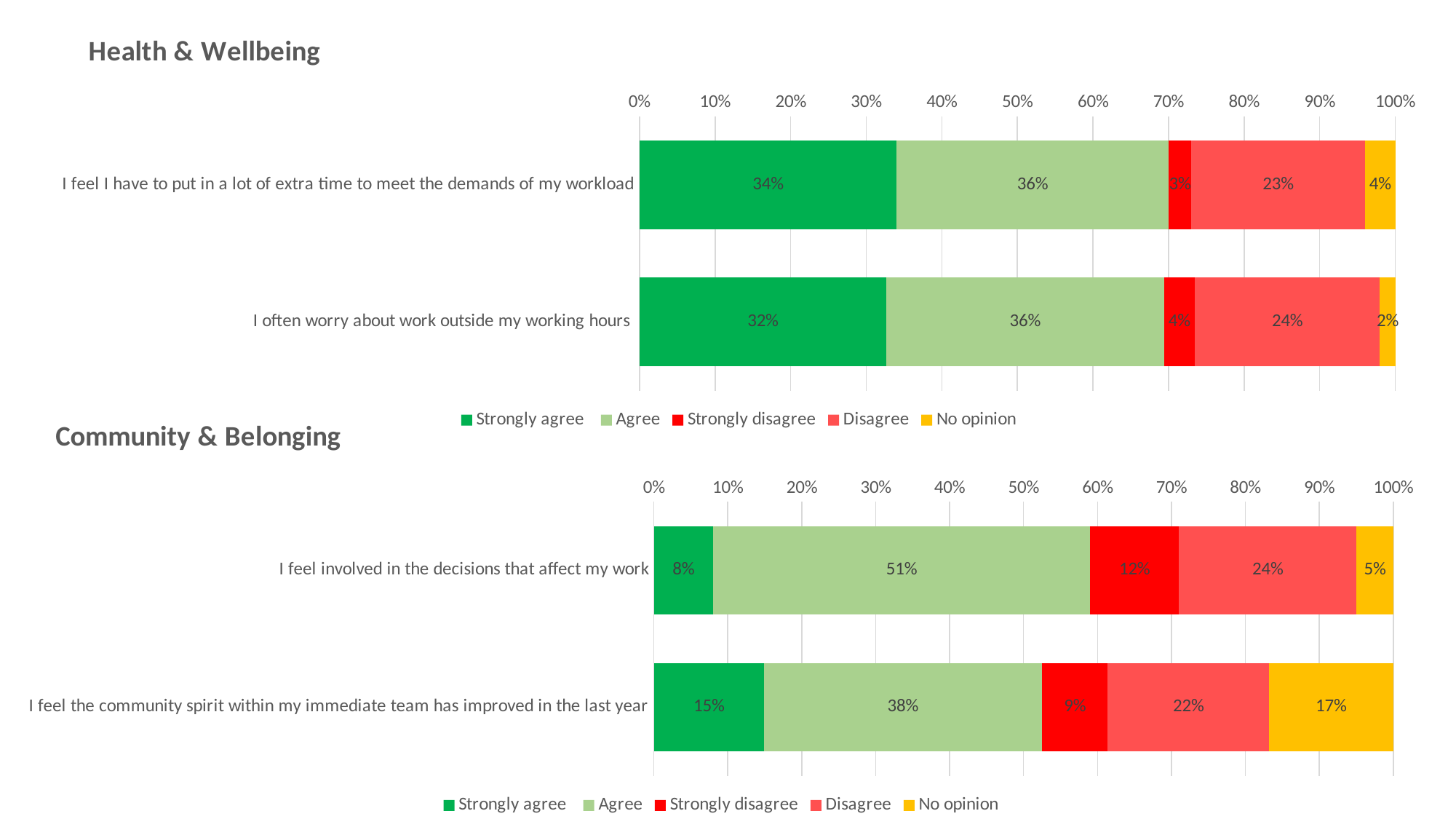
In the Health & Wellbeing chart, what percentage disagree with 'I often worry about work outside my working hours'? 24% How many series does the legend of the Health & Wellbeing chart list? 5 In the Community & Belonging chart, what percentage agree that they feel involved in the decisions that affect their work? 51% In the Community & Belonging chart, what colour represents the No opinion series? Yellow In the Health & Wellbeing chart, what percentage strongly agree that they have to put in a lot of extra time to meet the demands of their workload? 34% In the Community & Belonging chart, which response category has the largest share for 'I feel the community spirit within my immediate team has improved in the last year'? Agree What kind of chart is the Health & Wellbeing chart? Stacked bar chart In the Community & Belonging chart, which statement has the higher Strongly disagree percentage? I feel involved in the decisions that affect my work In the Community & Belonging chart, what percentage have no opinion on whether the community spirit within their immediate team has improved in the last year? 17% In the Health & Wellbeing chart, which statement has the higher Strongly agree percentage? I feel I have to put in a lot of extra time to meet the demands of my workload How many statements are plotted in the Community & Belonging chart? 2 In the Community & Belonging chart, what is the difference between the Agree and Strongly agree percentages for 'I feel involved in the decisions that affect my work'? 43%